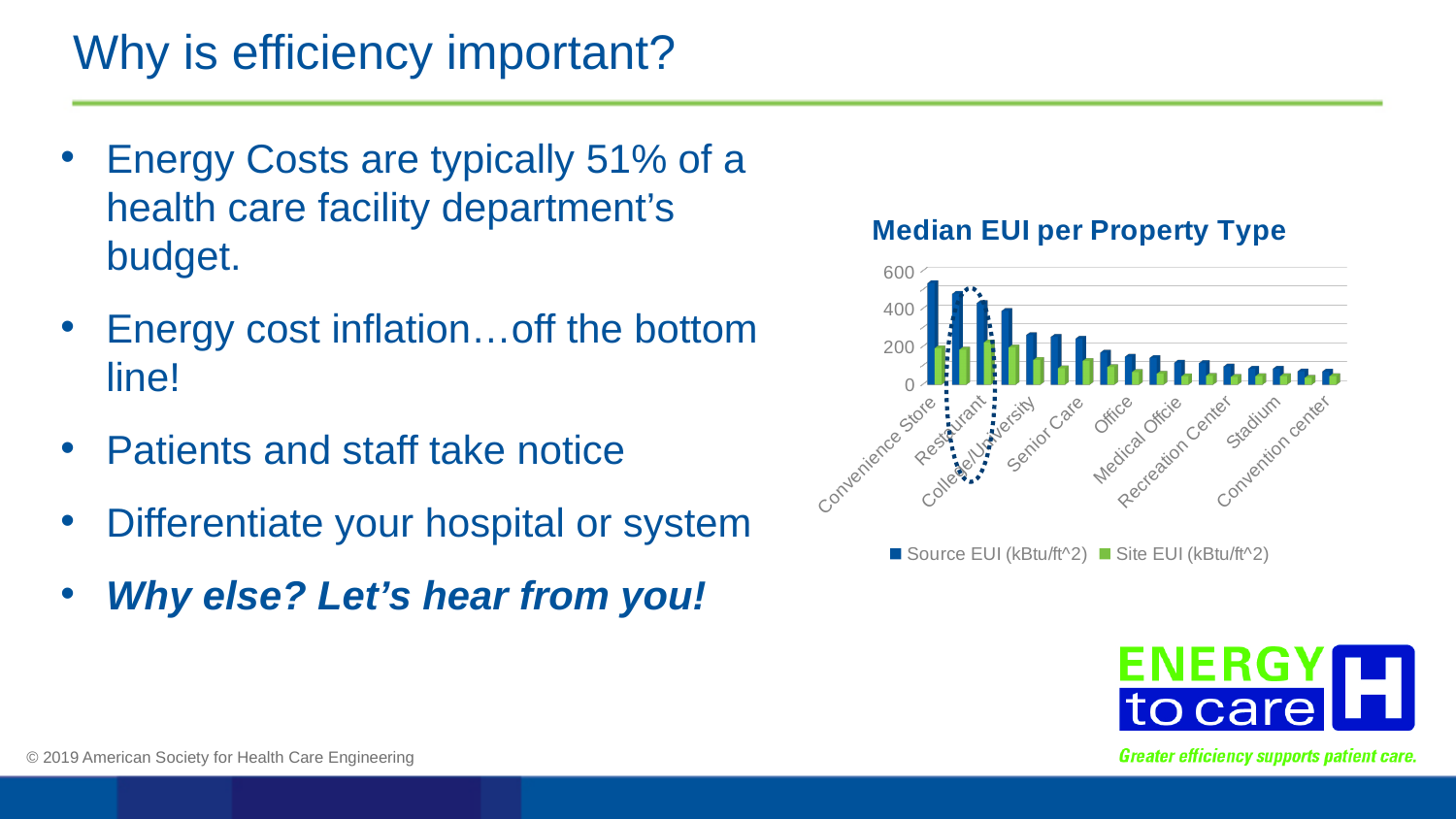
Which property type has the highest Source EUI in the chart? Convenience Store Is the Source EUI value for Convention center greater or less than 200? less Which has the larger Source EUI: Convenience Store or Convention center? Convenience Store Do the Source EUI values generally rise or fall moving from left to right across the property types? Fall For Convenience Store, which is larger: Source EUI or Site EUI? Source EUI Is the Source EUI value for Senior Care greater or less than 200? greater How many series does the chart's legend list? 2 What kind of chart is shown on the slide? Bar chart What is the title of the chart? Median EUI per Property Type What are the two series named in the chart's legend? Source EUI (kBtu/ft^2) and Site EUI (kBtu/ft^2) Is the Source EUI value for Convenience Store greater or less than 400? greater